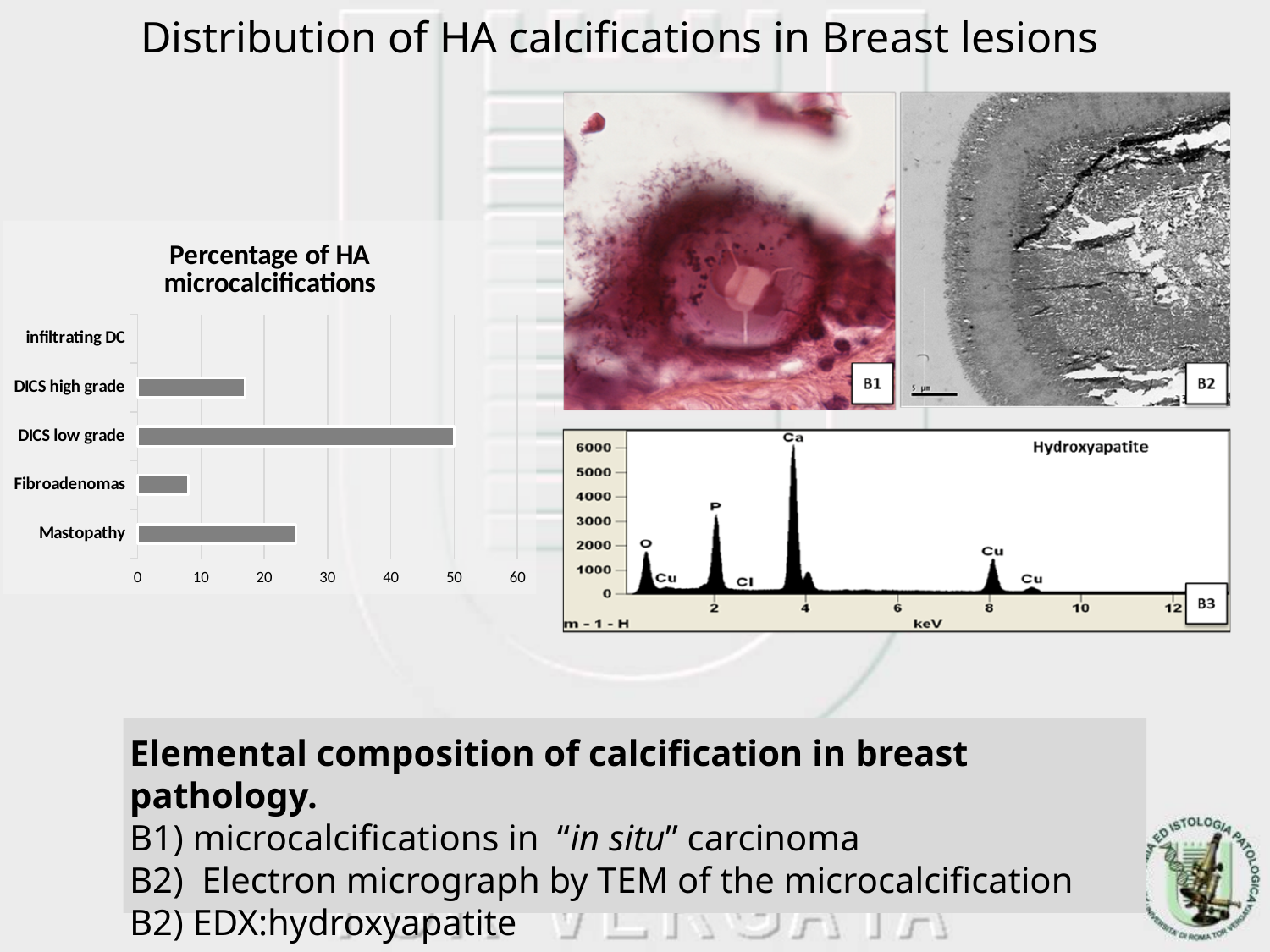
How many categories are listed on the 'Percentage of HA microcalcifications' chart? 5 What kind of chart is the 'Percentage of HA microcalcifications' chart? bar chart In the 'Percentage of HA microcalcifications' chart, is the value for Fibroadenomas greater or less than 10? less In the 'Percentage of HA microcalcifications' chart, is the value for DICS low grade greater or less than 40? greater In the 'Percentage of HA microcalcifications' chart, is the value for Mastopathy greater or less than 20? greater What is the title of the bar chart on the left of the slide? Percentage of HA microcalcifications In the 'Percentage of HA microcalcifications' chart, which is larger, the value for Mastopathy or the value for DICS high grade? Mastopathy In the 'Percentage of HA microcalcifications' chart, which is larger, the value for Fibroadenomas or the value for DICS low grade? DICS low grade In the 'Percentage of HA microcalcifications' chart, which category has the highest value? DICS low grade In the EDX spectrum labelled B3, which element has the tallest peak? Ca